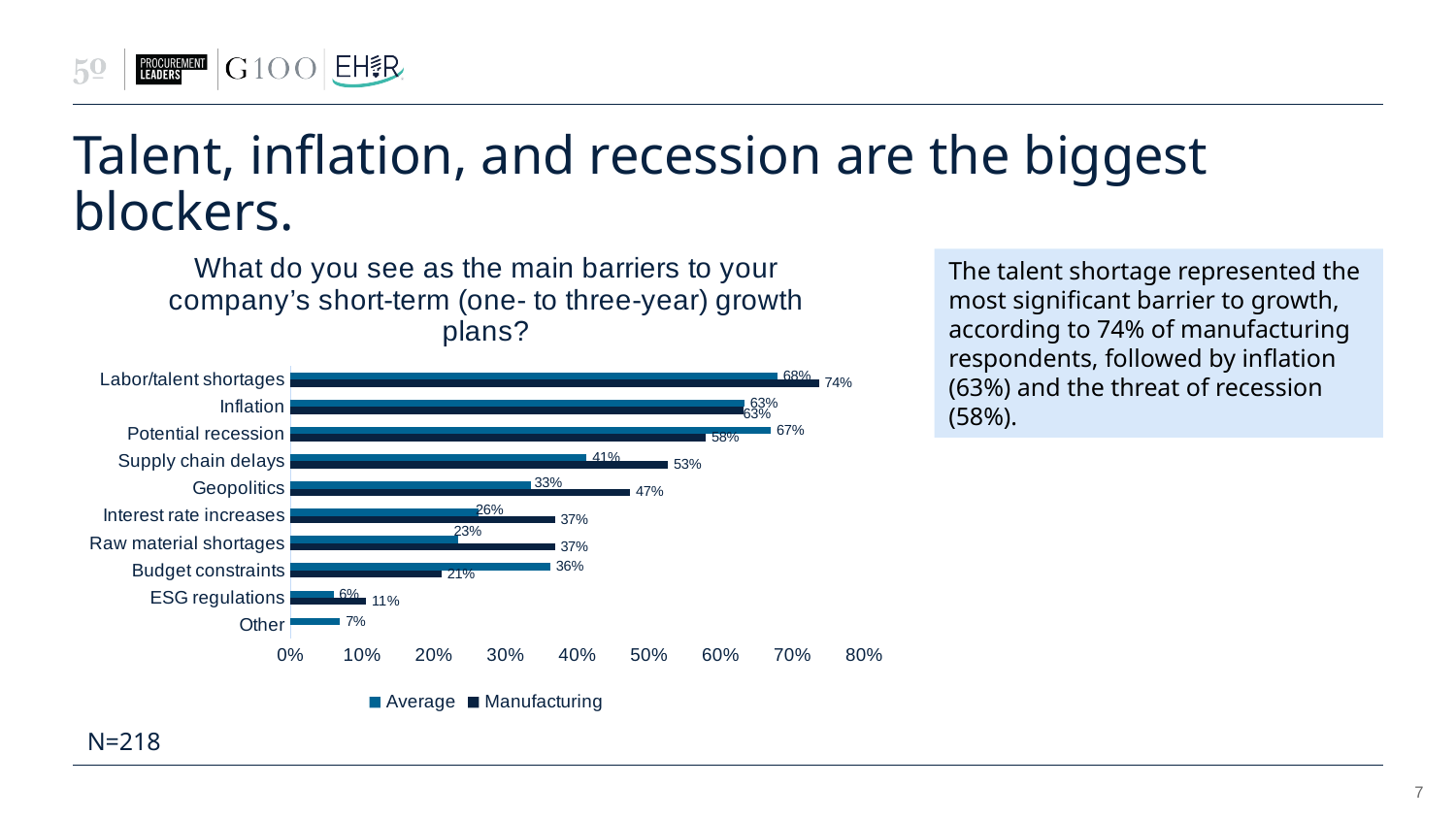
Which series does the darker navy bar represent according to the legend? Manufacturing What is the difference between the Manufacturing and Average values for Supply chain delays? 12% What is the Manufacturing value for Labor/talent shortages? 74% How many barrier categories are plotted on the chart? 10 What is the Manufacturing value for Geopolitics? 47% What type of chart is shown on the slide? Bar chart What is the Average value for Budget constraints? 36% Which category has the highest Manufacturing value? Labor/talent shortages What is the Average value for Potential recession? 67% How many series does the legend list? 2 Which is larger for Budget constraints, the Average value or the Manufacturing value? Average Which category has the lowest Average value? ESG regulations